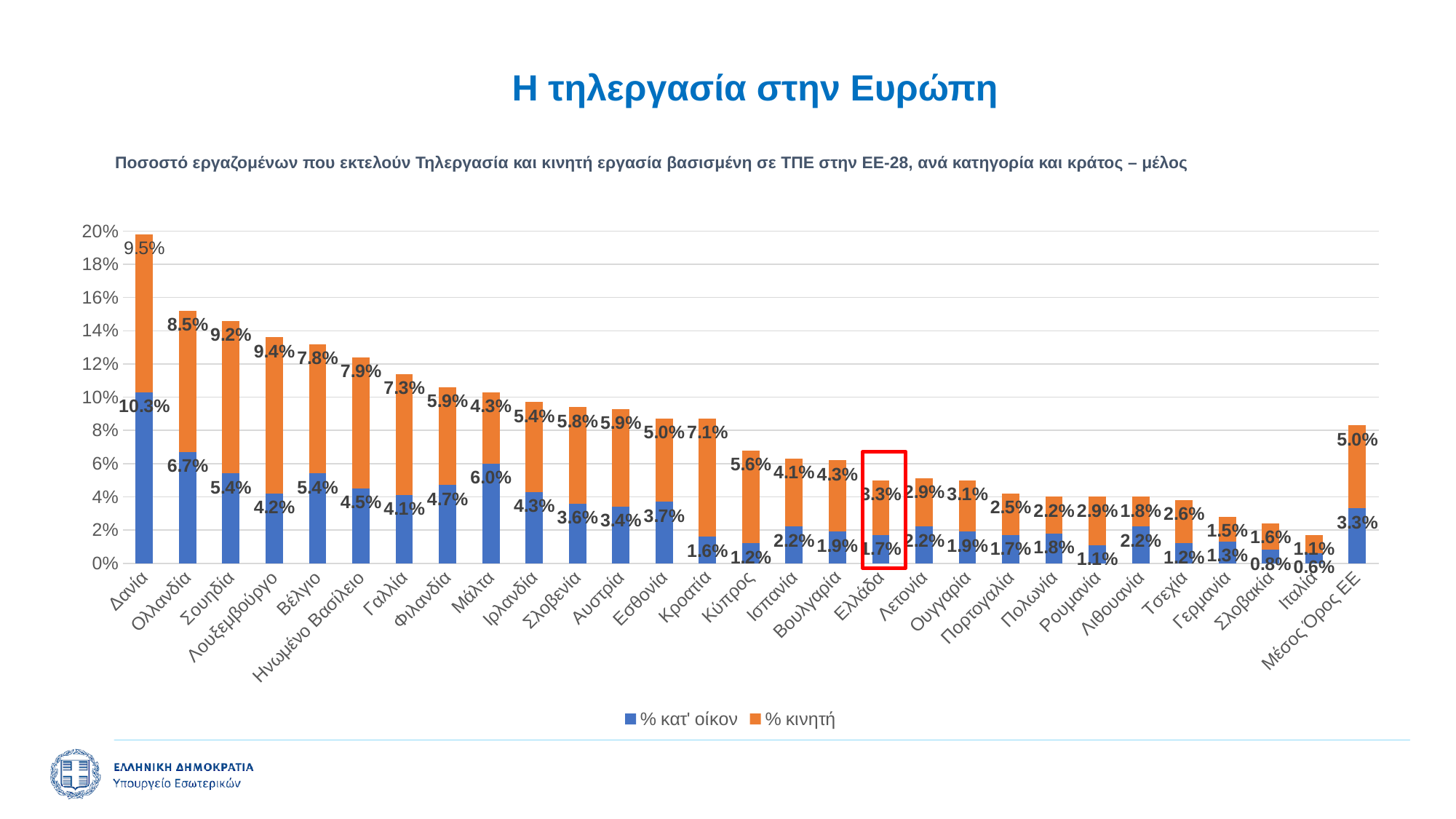
What is the total of the stacked bar for Ελλάδα? 5.0% How many series does the legend list? 2 Which country has the highest '% κατ' οίκον' value? Δανία Which country has the lowest '% κατ' οίκον' value? Ιταλία What is the difference between the '% κινητή' values for Δανία and Ολλανδία? 1.0% Which is larger, the '% κινητή' value for Κροατία or for Κύπρος? Κροατία What is the '% κινητή' value for Ελλάδα? 3.3% What is the '% κατ' οίκον' value for Δανία? 10.3% What kind of chart is shown on the slide? Stacked bar chart What is the '% κατ' οίκον' value for Μέσος Όρος ΕΕ? 3.3% Is the total stacked bar for Δανία greater or less than 18%? greater Which category is highlighted with a red box on the chart? Ελλάδα